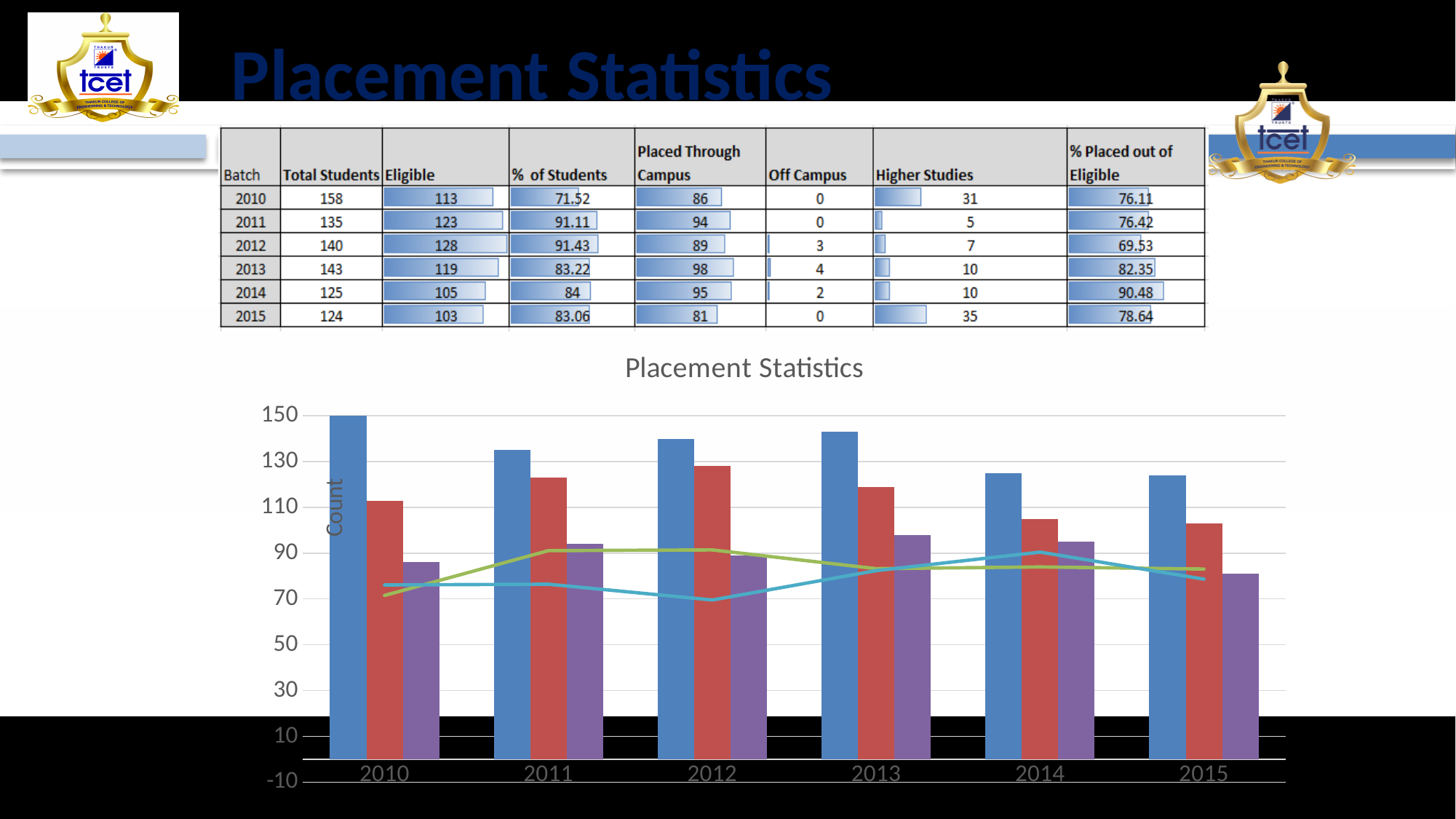
In the chart, is the purple bar for 2013 greater or less than 90? greater What is the title of the chart on the slide? Placement Statistics In the chart, is the purple bar for 2015 greater or less than 90? less What kind of chart is shown on the slide? Bar chart with line series What is the label on the vertical axis of the chart? Count In the chart, which year has the tallest blue bar? 2010 In the chart, which is taller for 2010: the blue bar or the red bar? The blue bar How many years (categories) are shown along the x axis of the chart? 6 In the chart, is the blue bar for 2011 greater or less than 130? greater How many bars are plotted for each year in the chart? 3